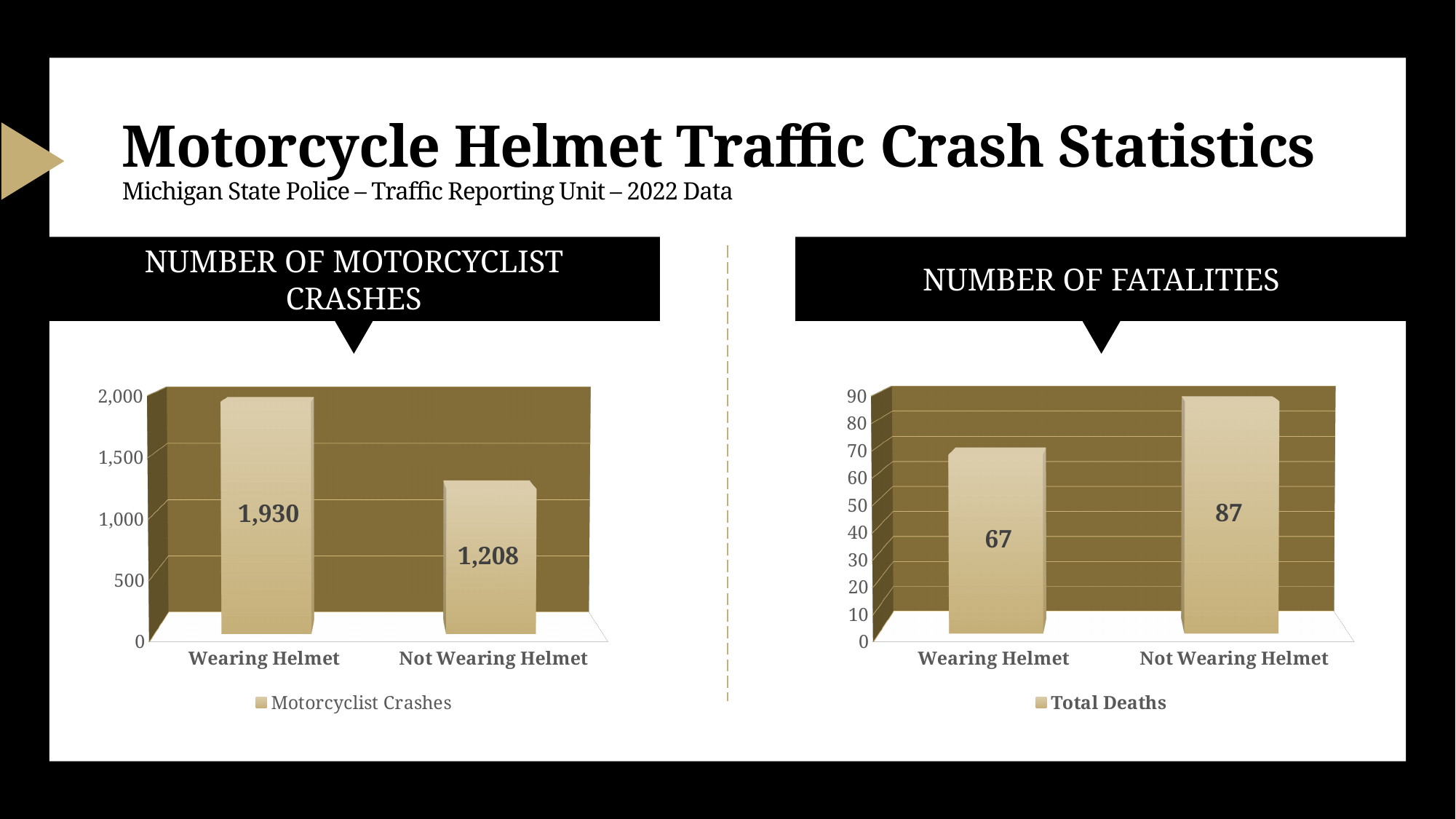
In the Number of Motorcyclist Crashes chart, what is the value for Wearing Helmet? 1,930 In the Number of Fatalities chart, what is the value for Not Wearing Helmet? 87 In the Number of Fatalities chart, what is the difference between the Not Wearing Helmet and Wearing Helmet values? 20 How many categories are shown in the Number of Motorcyclist Crashes chart? 2 What is the legend entry for the series in the Number of Fatalities chart? Total Deaths In the Number of Motorcyclist Crashes chart, what is the value for Not Wearing Helmet? 1,208 What kind of chart is the Number of Fatalities chart? Bar chart In the Number of Fatalities chart, is the value for Not Wearing Helmet greater or less than 80? greater In the Number of Fatalities chart, what is the value for Wearing Helmet? 67 In the Number of Motorcyclist Crashes chart, which category has the highest value? Wearing Helmet In the Number of Fatalities chart, which category has the lowest value? Wearing Helmet In the Number of Motorcyclist Crashes chart, what is the difference between the Wearing Helmet and Not Wearing Helmet values? 722